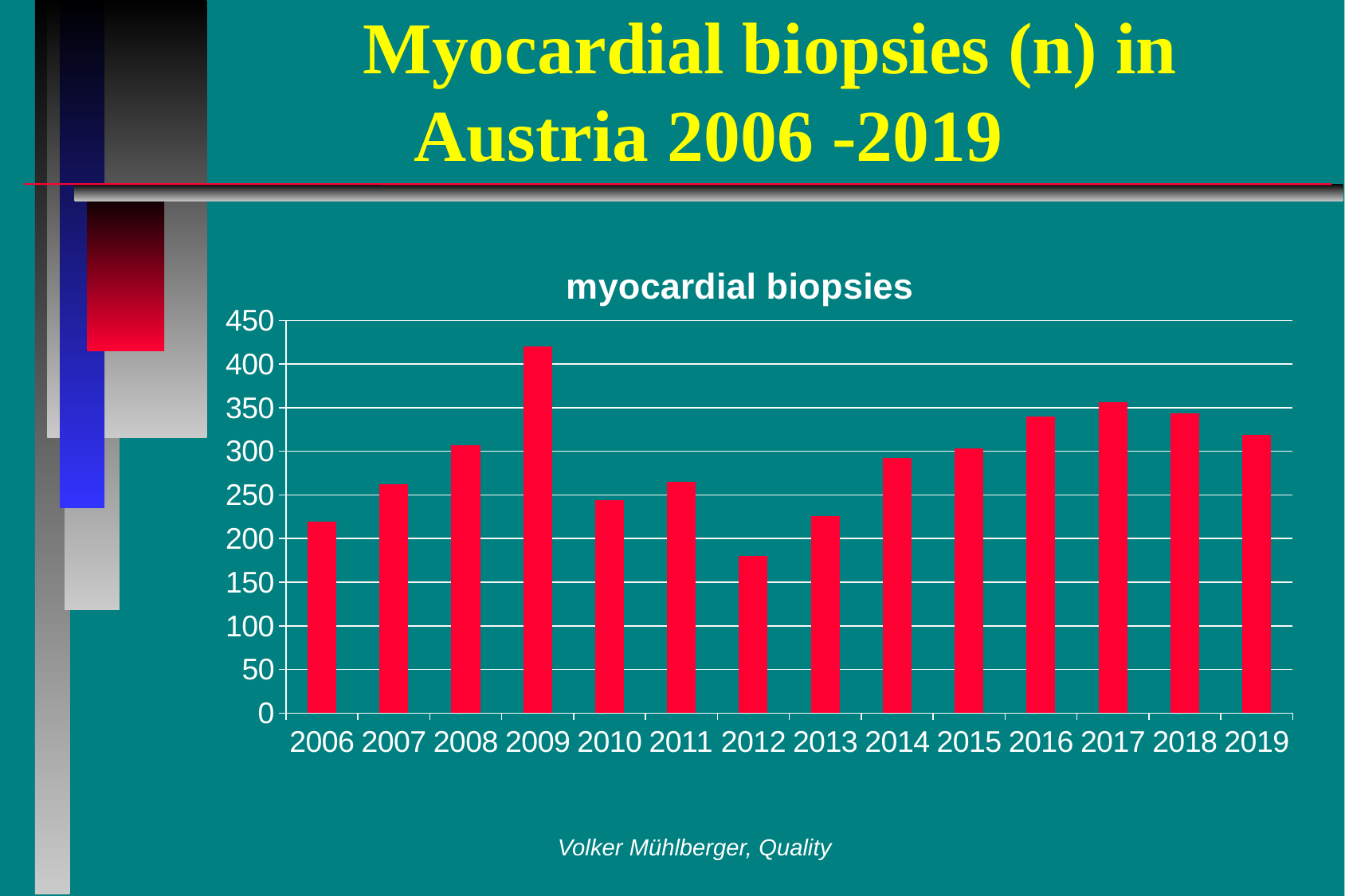
Which year has a larger value, 2010 or 2017? 2017 What type of chart is shown on the slide? bar chart Do the values rise or fall from 2012 to 2017? rise Which year has a larger value, 2016 or 2006? 2016 Is the value for 2013 greater or less than 250? less Which year has the lowest number of myocardial biopsies? 2012 How many years are shown on the x axis of the chart? 14 What is the title shown above the chart's plot area? myocardial biopsies Which year has the highest number of myocardial biopsies? 2009 Is the value for 2012 greater or less than 200? less Is the value for 2006 greater or less than 200? greater